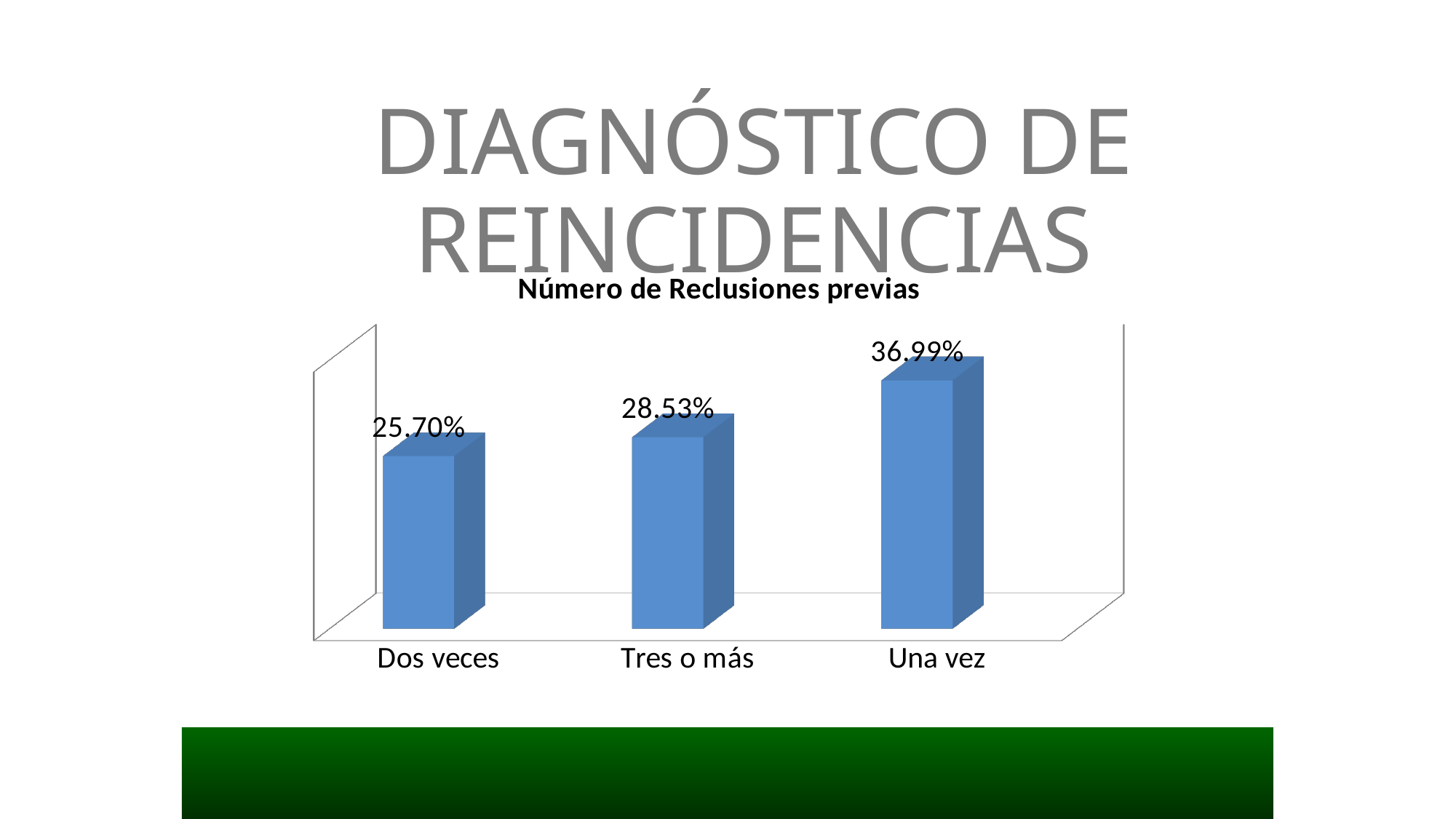
Which category has the lowest value? Dos veces What is the title of the chart? Número de Reclusiones previas What is the value for Tres o más? 28.53% Do the values rise or fall from left to right along the x axis? Rise What is the difference between the values for Una vez and Dos veces? 11.29% How many categories are shown in the chart? 3 Which category has the highest value? Una vez What is the value for Dos veces? 25.70% What kind of chart is shown on the slide? Bar chart What is the value for Una vez? 36.99% Which is larger, the value for Tres o más or the value for Una vez? Una vez What is the difference between the values for Tres o más and Dos veces? 2.83%